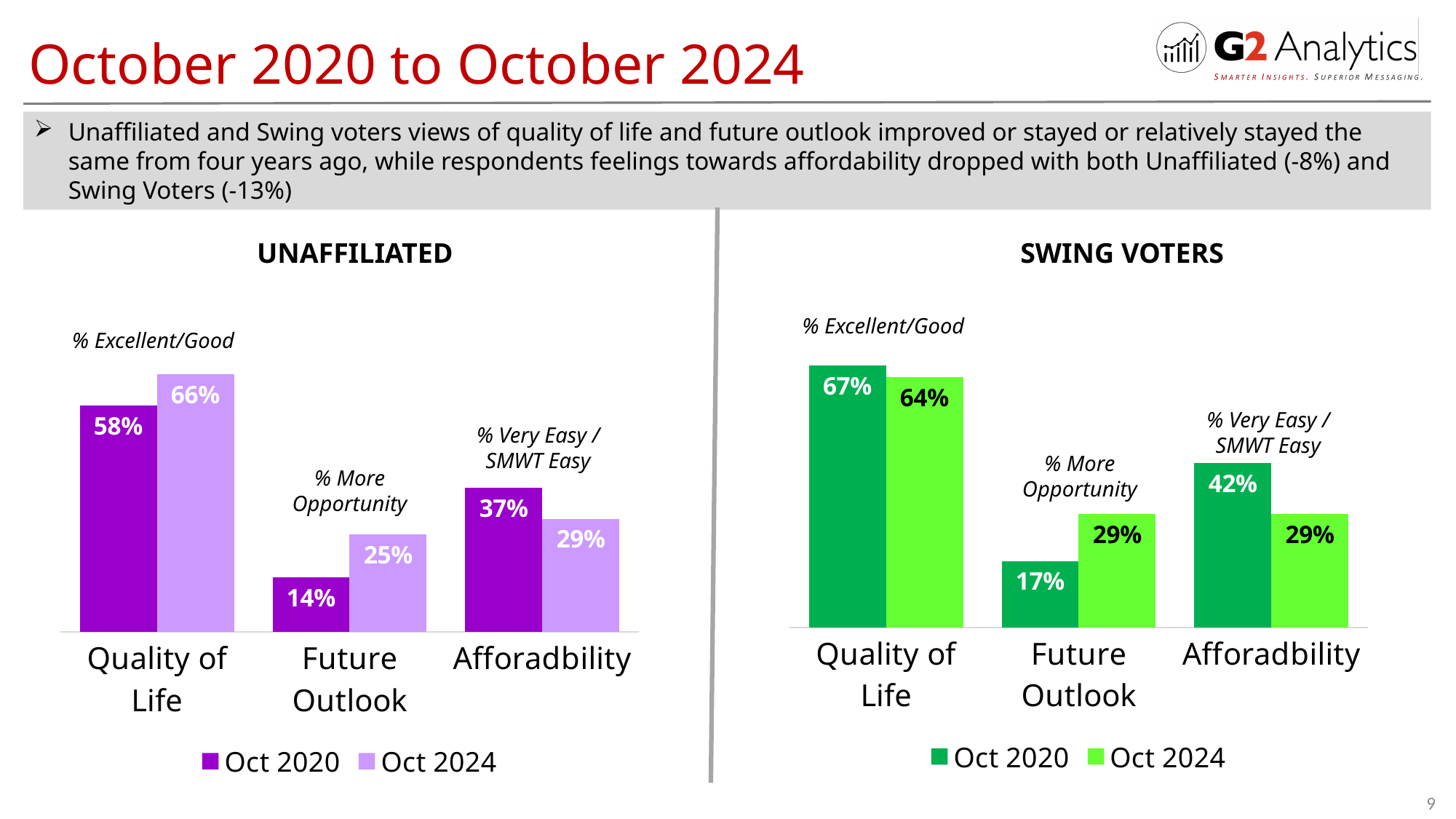
In the UNAFFILIATED chart, what is the Oct 2024 value for Quality of Life? 66% In the SWING VOTERS chart, what is the Oct 2024 value for Quality of Life? 64% In the UNAFFILIATED chart, which category has the lowest Oct 2020 value? Future Outlook What kind of chart is the UNAFFILIATED chart? Bar chart In the UNAFFILIATED chart, what is the Oct 2020 value for Future Outlook? 14% In the SWING VOTERS chart, which is larger for Future Outlook: the Oct 2020 value or the Oct 2024 value? Oct 2024 In the SWING VOTERS chart, what is the difference between the Oct 2020 and Oct 2024 values for Affordability? 13% How many categories are shown on the x axis of the UNAFFILIATED chart? 3 In the SWING VOTERS chart, which category has the highest Oct 2024 value? Quality of Life How many series does the legend of the SWING VOTERS chart list? 2 In the UNAFFILIATED chart, what is the difference between the Oct 2020 and Oct 2024 values for Affordability? 8% In the SWING VOTERS chart, what is the Oct 2020 value for Affordability? 42%